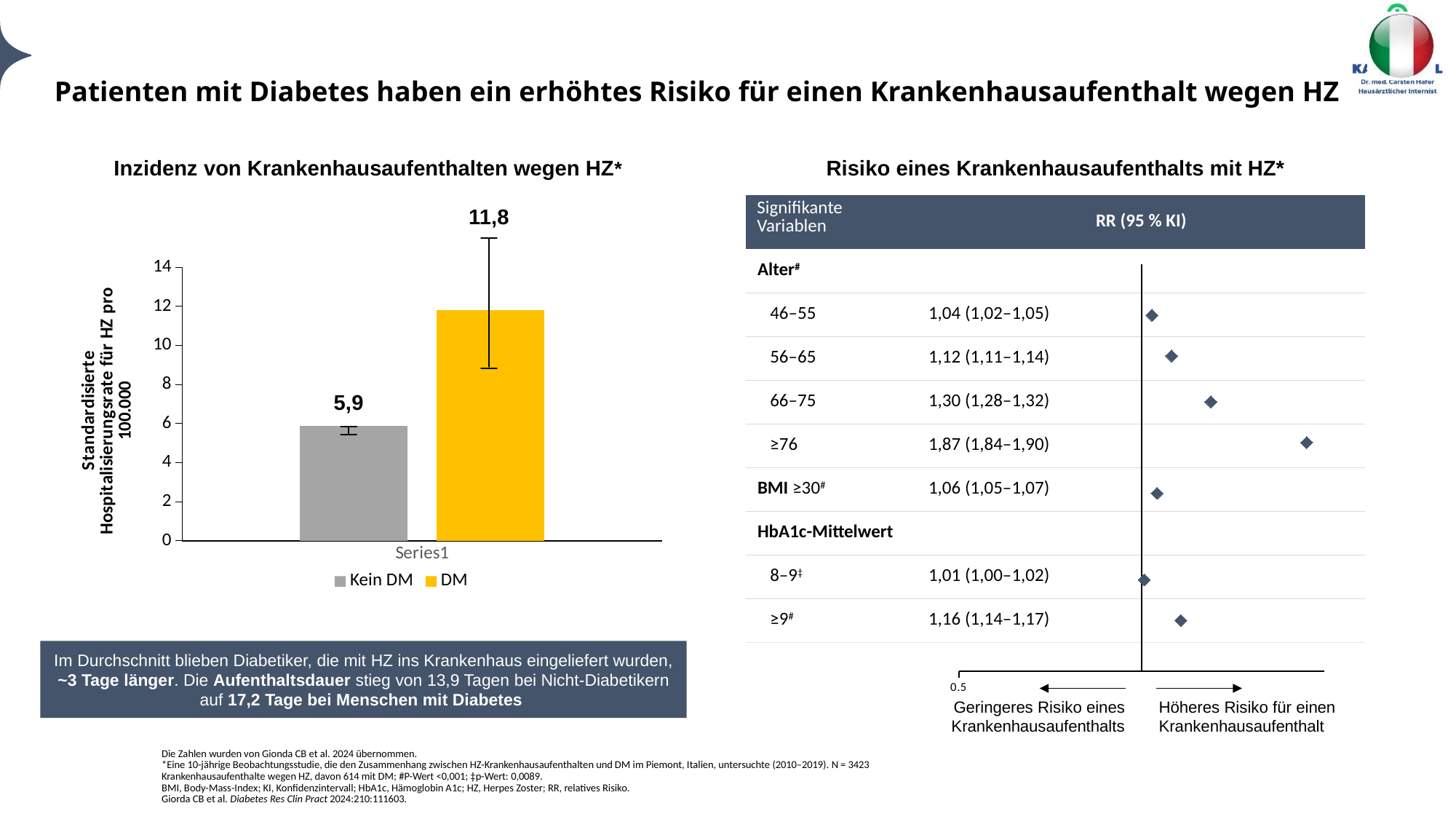
In the chart 'Inzidenz von Krankenhausaufenthalten wegen HZ*', what is the difference between the DM and Kein DM values? 5,9 What kind of chart is 'Inzidenz von Krankenhausaufenthalten wegen HZ*'? bar chart In the chart 'Inzidenz von Krankenhausaufenthalten wegen HZ*', is the value for DM greater or less than 10? greater In the chart 'Inzidenz von Krankenhausaufenthalten wegen HZ*', what is the value for Kein DM? 5,9 In the chart 'Risiko eines Krankenhausaufenthalts mit HZ*', what is the RR (95 % KI) for BMI ≥30? 1,06 (1,05–1,07) In the chart 'Inzidenz von Krankenhausaufenthalten wegen HZ*', what colour is the DM bar? yellow In the chart 'Inzidenz von Krankenhausaufenthalten wegen HZ*', what is the value for DM? 11,8 In the chart 'Risiko eines Krankenhausaufenthalts mit HZ*', which has the larger RR: age 66–75 or HbA1c ≥9? 66–75 In the chart 'Inzidenz von Krankenhausaufenthalten wegen HZ*', how many series does the legend list? 2 In the chart 'Inzidenz von Krankenhausaufenthalten wegen HZ*', which series has the higher value? DM In the chart 'Risiko eines Krankenhausaufenthalts mit HZ*', what is the RR (95 % KI) for the age group ≥76? 1,87 (1,84–1,90) In the chart 'Risiko eines Krankenhausaufenthalts mit HZ*', which variable has the highest RR? ≥76